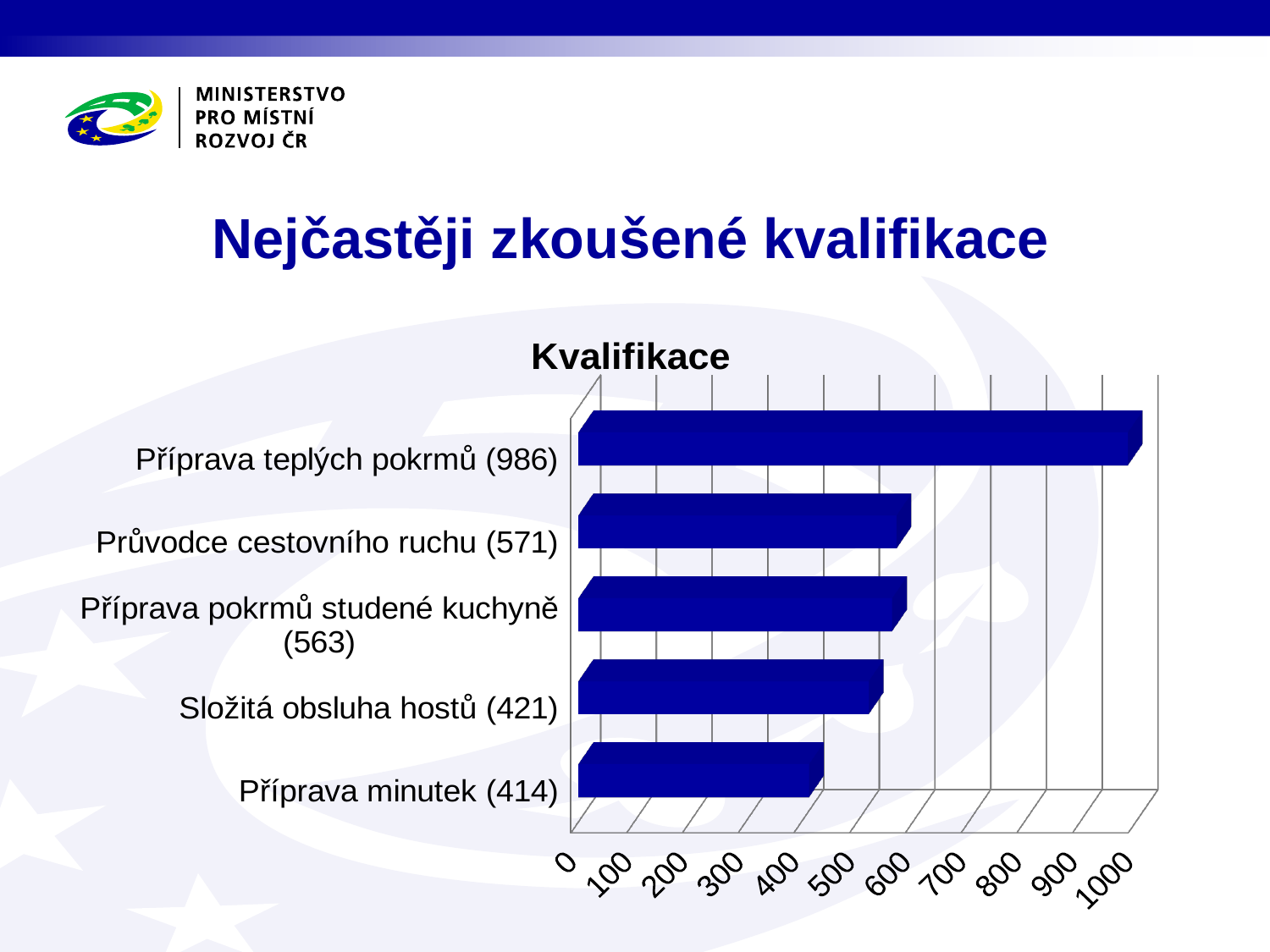
What is the title of the chart? Kvalifikace How many categories does the chart show? 5 What is the value for Příprava minutek? 414 What type of chart is shown on the slide? bar chart What is the difference between the values for Příprava teplých pokrmů and Průvodce cestovního ruchu? 415 What is the value for Příprava pokrmů studené kuchyně? 563 Which category has the lowest value? Příprava minutek What is the value for Průvodce cestovního ruchu? 571 Which is larger, the value for Příprava pokrmů studené kuchyně or the value for Složitá obsluha hostů? Příprava pokrmů studené kuchyně What is the value for Příprava teplých pokrmů? 986 What is the value for Složitá obsluha hostů? 421 Which category has the highest value? Příprava teplých pokrmů